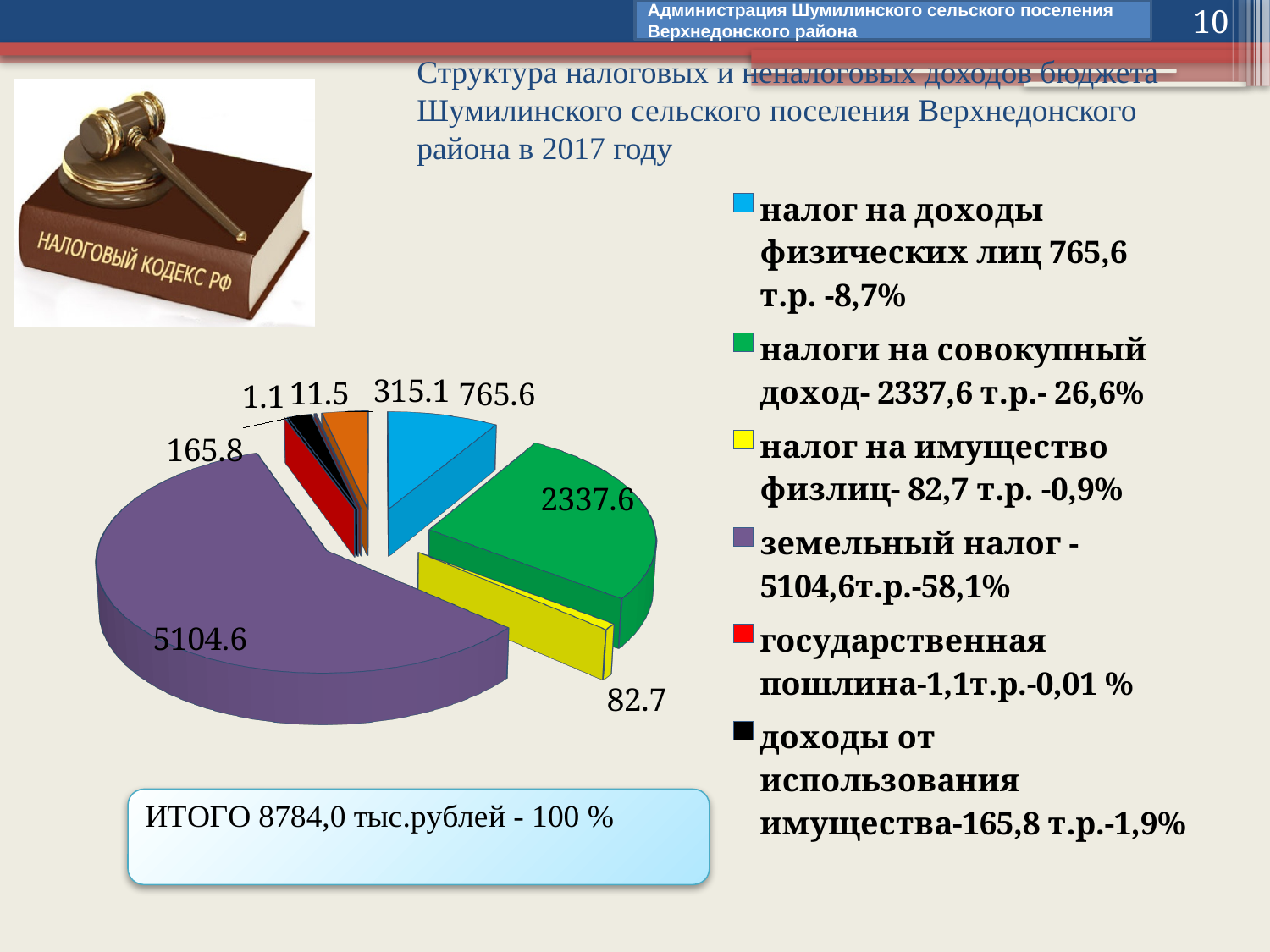
What is the difference between the values for земельный налог and налоги на совокупный доход? 2767 What kind of chart is shown on the slide? pie chart What value is shown on the pie chart for налоги на совокупный доход? 2337.6 What value is shown on the pie chart for земельный налог? 5104.6 What value is shown on the pie chart for налог на имущество физлиц? 82.7 How many entries does the chart legend list? 6 What share of the total does земельный налог represent, according to the legend? 58,1% Which legend category has the smallest slice of the pie chart? государственная пошлина What colour is the slice for земельный налог? purple Which category has the largest slice of the pie chart? земельный налог Which is larger: налог на доходы физических лиц or доходы от использования имущества? налог на доходы физических лиц How many data labels are printed on the pie chart? 8